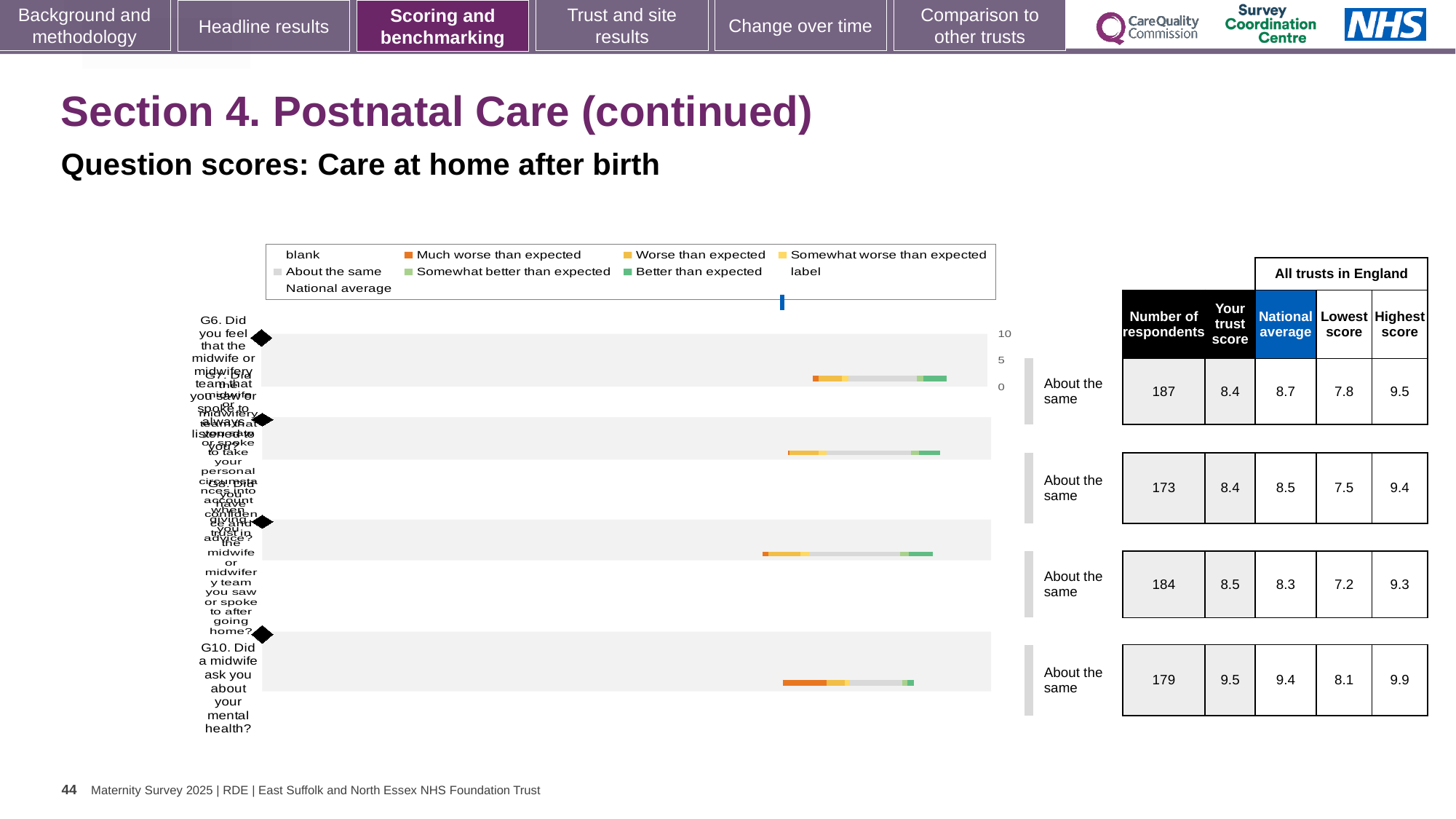
What is the difference between the trust score and the national average for G6? 0.3 What is the national average shown for G10 (Did a midwife ask you about your mental health)? 9.4 What is the number of respondents shown for G6? 187 How many question bars are plotted in the chart? 4 What is the trust score shown for G10 (Did a midwife ask you about your mental health)? 9.5 What is the trust score shown for the first question, G6? 8.4 What kind of chart is shown on the slide? bar chart What is the benchmark category shown next to the bar for G10 (Did a midwife ask you about your mental health)? About the same Which question has the highest trust score in the table beside the chart? G10 Which legend entry is shown in dark orange in the chart? Much worse than expected Is the trust score for G10 larger or smaller than its national average? larger Which legend entry is shown in grey in the chart? About the same